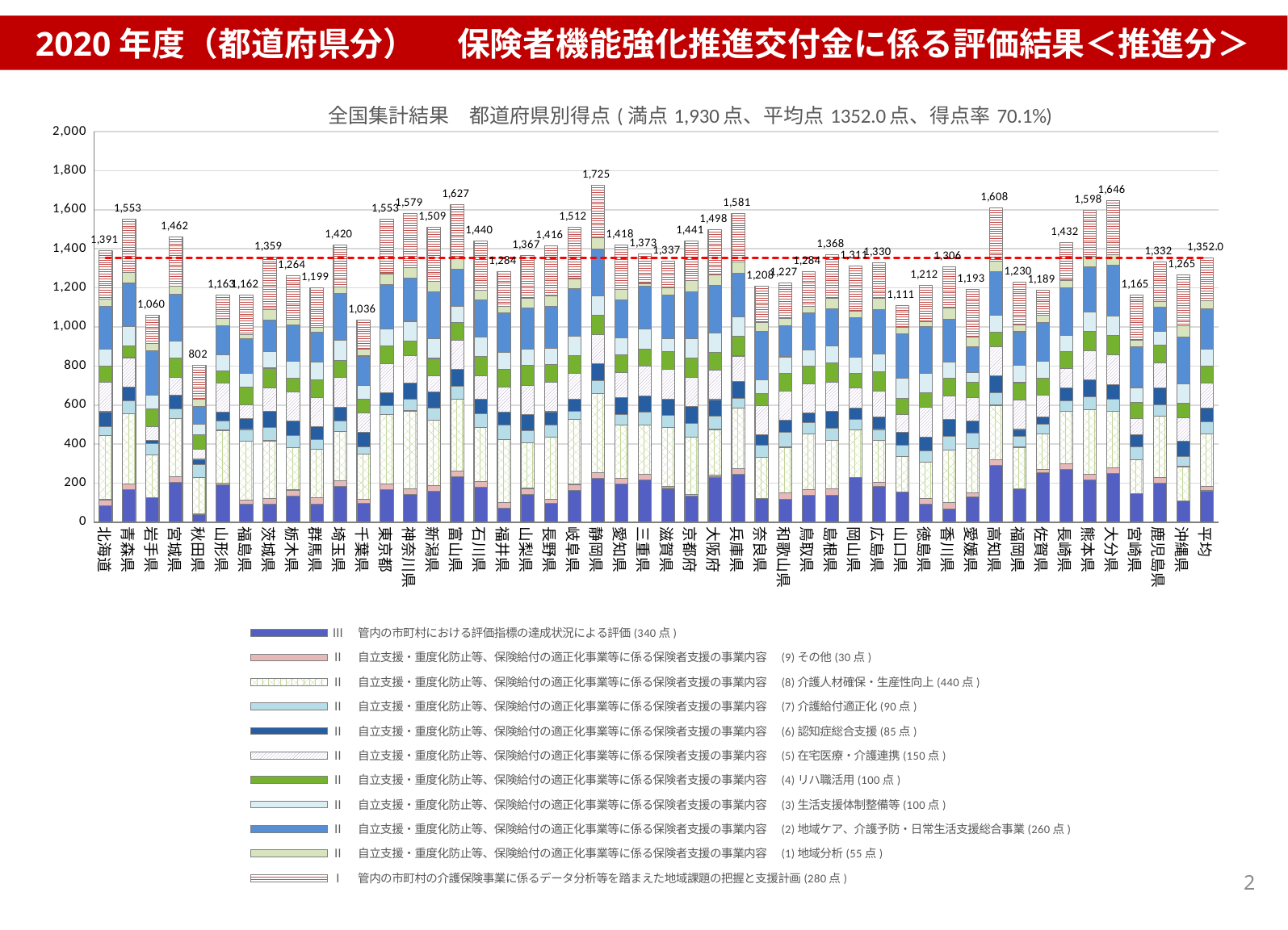
What kind of chart is shown on the slide? Stacked bar chart Which has a higher total score, 大分県 or 高知県? 大分県 What is the 得点率 (score rate) stated in the chart title? 70.1% What is the total of the stacked bar for 富山県? 1,627 How many series does the legend list? 11 What is the total score shown for 静岡県? 1,725 Which prefecture has the lowest total score? 秋田県 What is the value shown for 平均 (the average bar) at the far right? 1,352.0 Which prefecture has the highest total score? 静岡県 What is the total score shown for 秋田県? 802 Is the total score for 千葉県 greater or less than 1,200? less What is the difference between the total scores of 静岡県 and 秋田県? 923